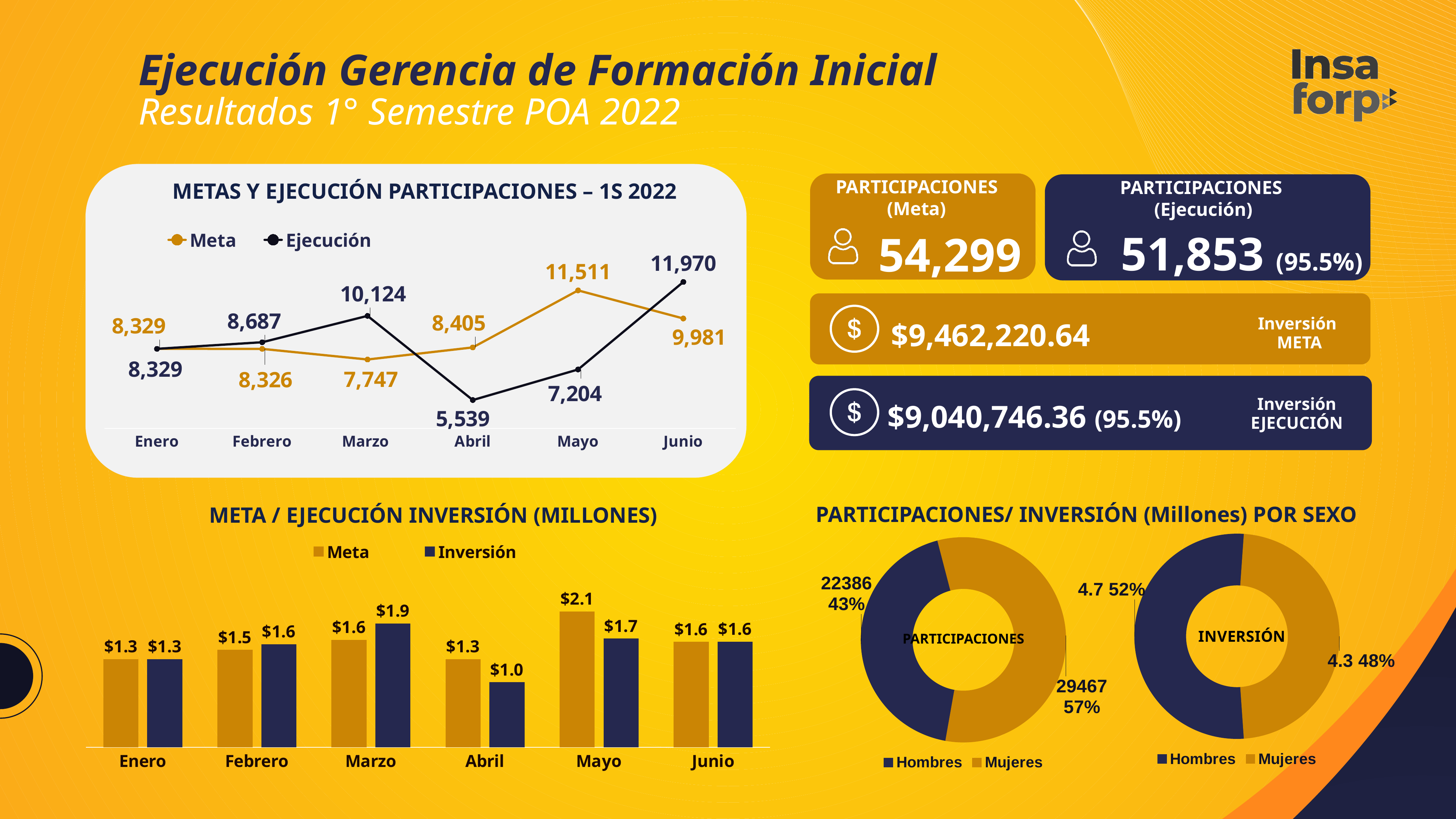
In the 'METAS Y EJECUCIÓN PARTICIPACIONES – 1S 2022' chart, what is the Meta value for Mayo? 11,511 In the PARTICIPACIONES donut chart, what share of the total is Mujeres? 57% In the 'METAS Y EJECUCIÓN PARTICIPACIONES – 1S 2022' chart, which month has the lowest Ejecución value? Abril In the 'METAS Y EJECUCIÓN PARTICIPACIONES – 1S 2022' chart, how many series does the legend list? 2 What kind of chart is 'METAS Y EJECUCIÓN PARTICIPACIONES – 1S 2022'? Line chart In the 'META / EJECUCIÓN INVERSIÓN (MILLONES)' chart, which month has the highest Meta value? Mayo In the 'META / EJECUCIÓN INVERSIÓN (MILLONES)' chart, is the Meta or the Inversión value larger for Marzo? Inversión In the 'METAS Y EJECUCIÓN PARTICIPACIONES – 1S 2022' chart, what is the difference between the Ejecución and Meta values for Junio? 1,989 In the INVERSIÓN donut chart, what is the value for Hombres? 4.7 In the 'METAS Y EJECUCIÓN PARTICIPACIONES – 1S 2022' chart, what is the Ejecución value for Marzo? 10,124 How many months are shown on the x axis of the 'META / EJECUCIÓN INVERSIÓN (MILLONES)' chart? 6 In the 'META / EJECUCIÓN INVERSIÓN (MILLONES)' chart, what is the Inversión value for Abril? $1.0